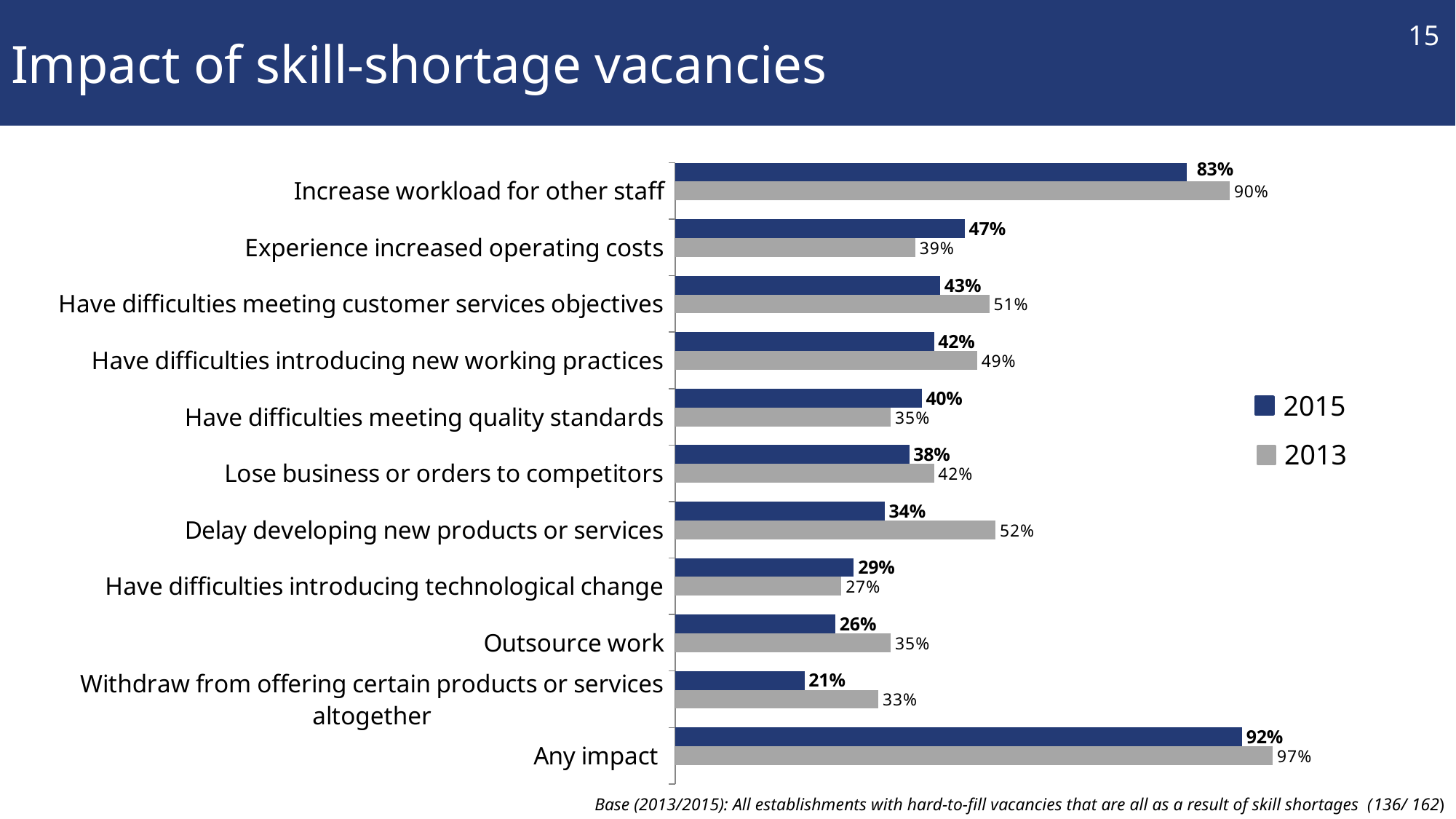
For "Experience increased operating costs", which year has the larger value, 2015 or 2013? 2015 How many series does the legend list? 2 For "Have difficulties meeting customer services objectives", which year has the larger value, 2015 or 2013? 2013 Which category has the highest 2013 value? Any impact What is the difference between the 2013 and 2015 values for "Delay developing new products or services"? 18% What is the 2015 value for "Increase workload for other staff"? 83% Which category has the lowest 2015 value? Withdraw from offering certain products or services altogether What is the 2015 value for "Outsource work"? 26% Which colour represents the 2013 series in the legend? Grey What kind of chart is shown on the slide? Bar chart How many categories are shown on the chart? 11 What is the 2013 value for "Delay developing new products or services"? 52%